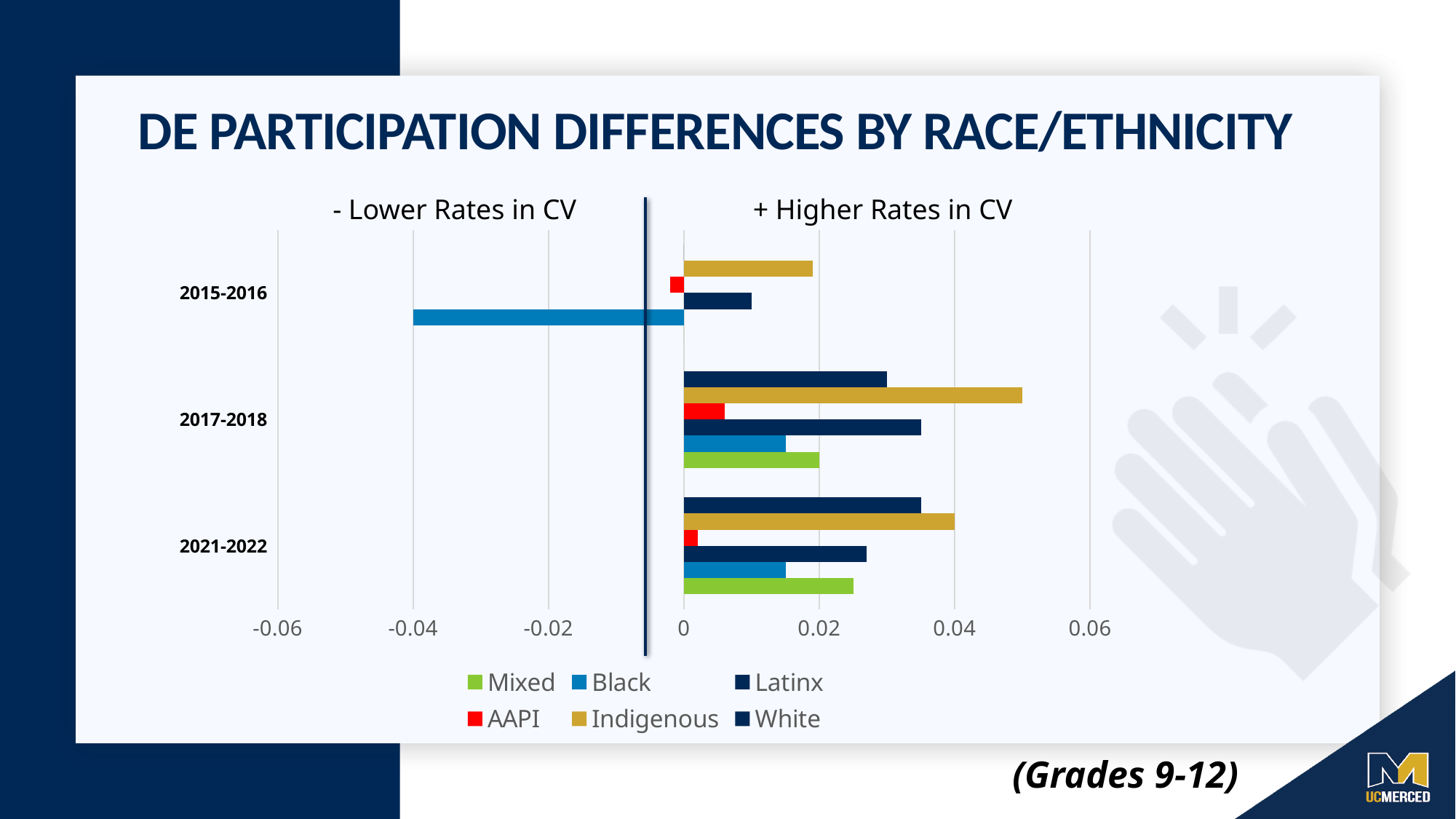
How many school-year categories are shown on the y axis? 3 How many series does the legend list? 6 What kind of chart is shown on the slide? bar chart What label appears above the right-hand side of the chart? + Higher Rates in CV Is the value for Indigenous in 2017-2018 greater or less than 0.04? greater Which is larger, the Indigenous value in 2017-2018 or the Indigenous value in 2021-2022? 2017-2018 Which series has the highest value in 2017-2018? Indigenous Is the value for AAPI in 2021-2022 greater or less than 0? greater Is the value for Mixed in 2021-2022 greater or less than 0.02? greater What is the value for Black in 2015-2016? -0.04 Which series has the lowest value in 2015-2016? Black